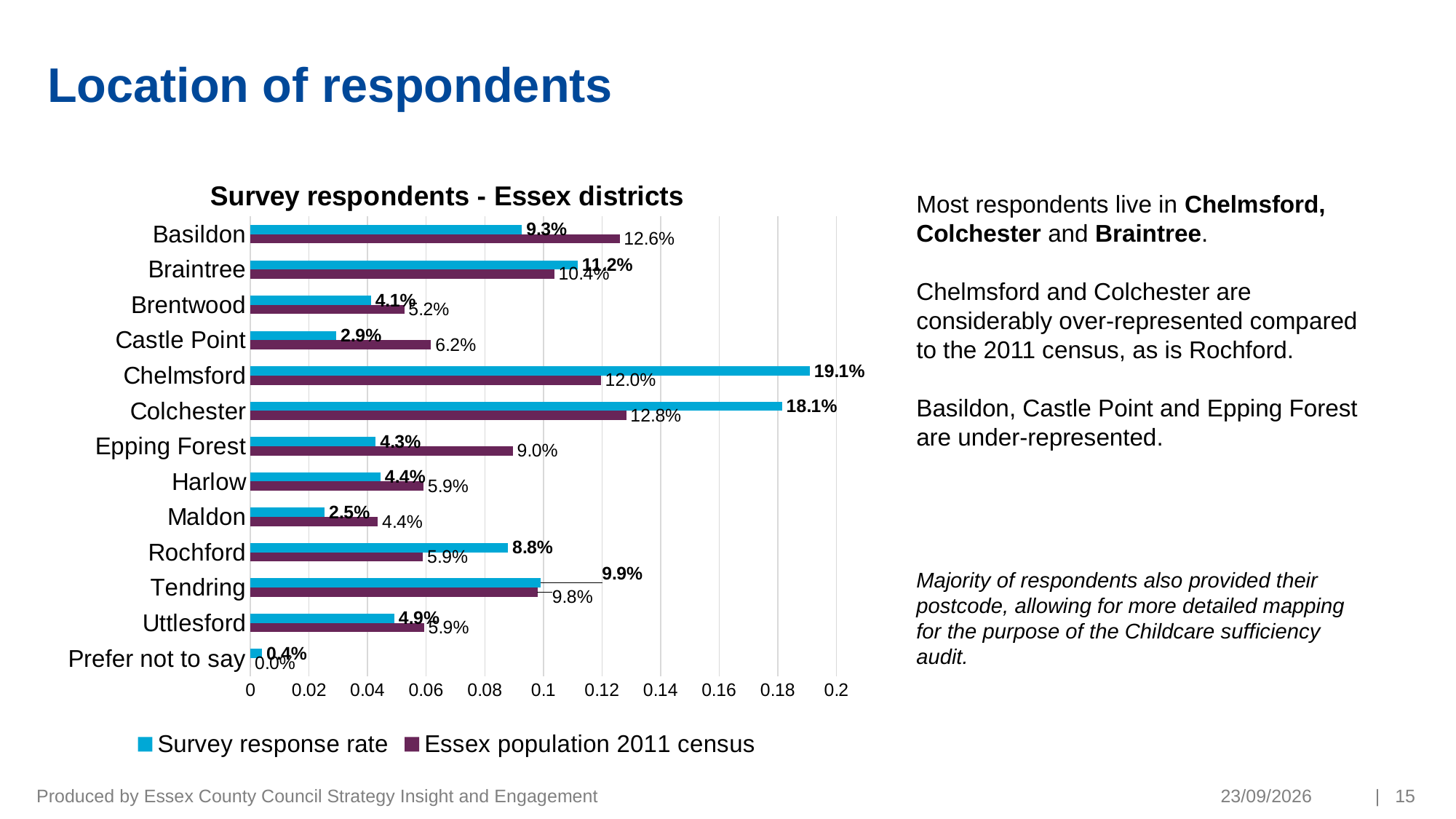
How many series does the legend list? 2 How many categories are shown on the chart? 13 What is the Essex population 2011 census value for Epping Forest? 9.0% Which category has the lowest survey response rate? Prefer not to say What is the survey response rate for Chelmsford? 19.1% What is the difference between the survey response rate and the 2011 census value for Chelmsford? 7.1 percentage points Which category has the highest survey response rate? Chelmsford Is the survey response rate for Colchester greater or less than 0.16? greater Which is larger for Castle Point: the survey response rate or the Essex population 2011 census value? Essex population 2011 census What is the title of the chart? Survey respondents - Essex districts What kind of chart is shown on the slide? Bar chart What is the survey response rate for Rochford? 8.8%